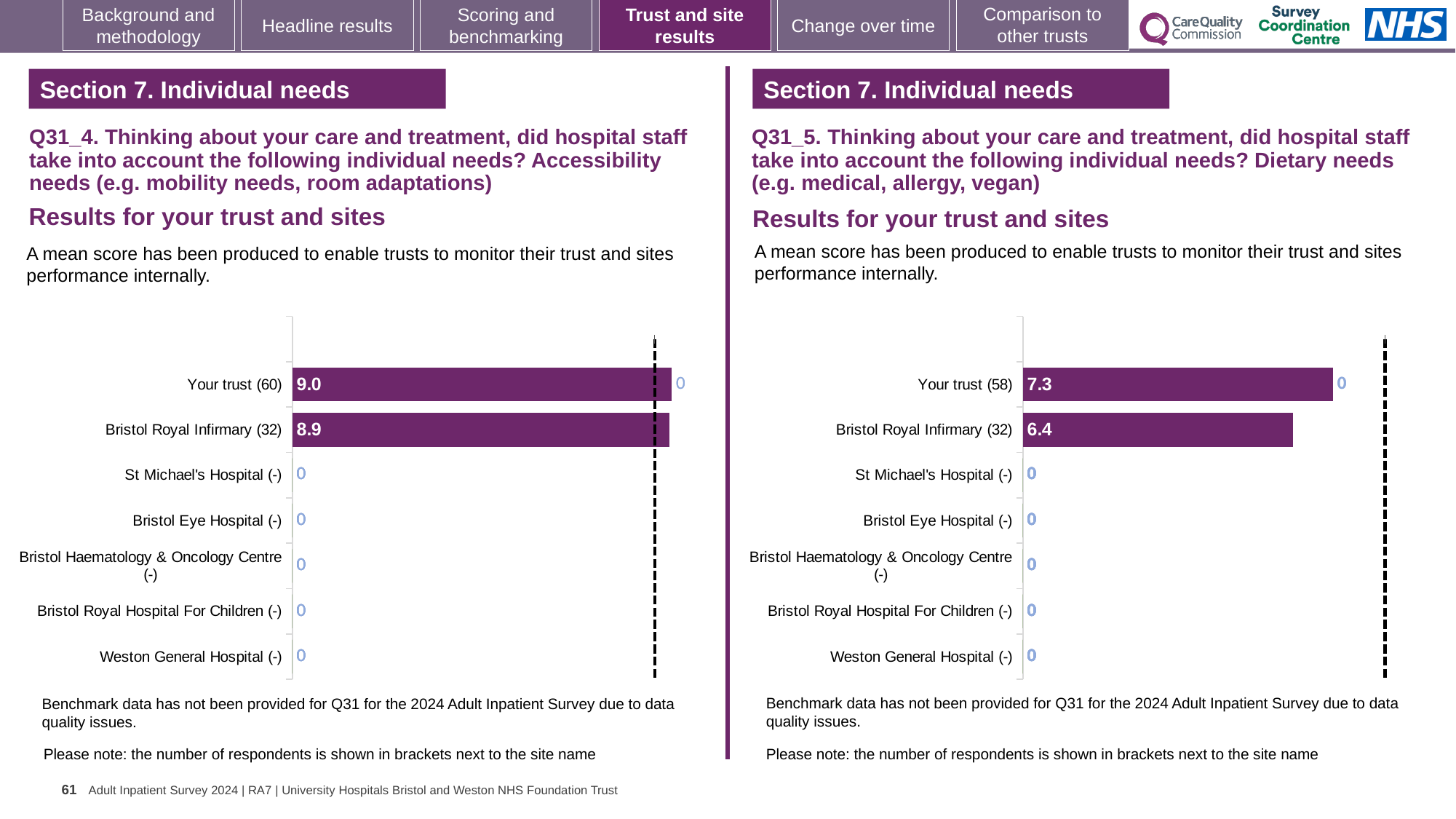
In the Q31_4 Accessibility needs chart on the left, what is the difference between the Your trust score and the Bristol Royal Infirmary score? 0.1 What type of chart is used for the Q31_5 Dietary needs results on the right? Bar chart In the Q31_4 Accessibility needs chart on the left, what is the mean score for Your trust? 9.0 In the Q31_5 Dietary needs chart on the right, what is the difference between the Your trust score and the Bristol Royal Infirmary score? 0.9 How many site categories are listed on the y axis of the Q31_4 Accessibility needs chart on the left? 7 In the Q31_4 Accessibility needs chart on the left, how many respondents are shown in brackets for Your trust? 60 In the Q31_5 Dietary needs chart on the right, what is the mean score for Your trust? 7.3 In the Q31_5 Dietary needs chart on the right, which has the higher score: Your trust or Bristol Royal Infirmary? Your trust In the Q31_5 Dietary needs chart on the right, which of the sites with a plotted bar has the lowest score? Bristol Royal Infirmary In the Q31_5 Dietary needs chart on the right, how many respondents are shown in brackets for Your trust? 58 In the Q31_5 Dietary needs chart on the right, what is the mean score for Bristol Royal Infirmary? 6.4 In the Q31_4 Accessibility needs chart on the left, what is the mean score for Bristol Royal Infirmary? 8.9